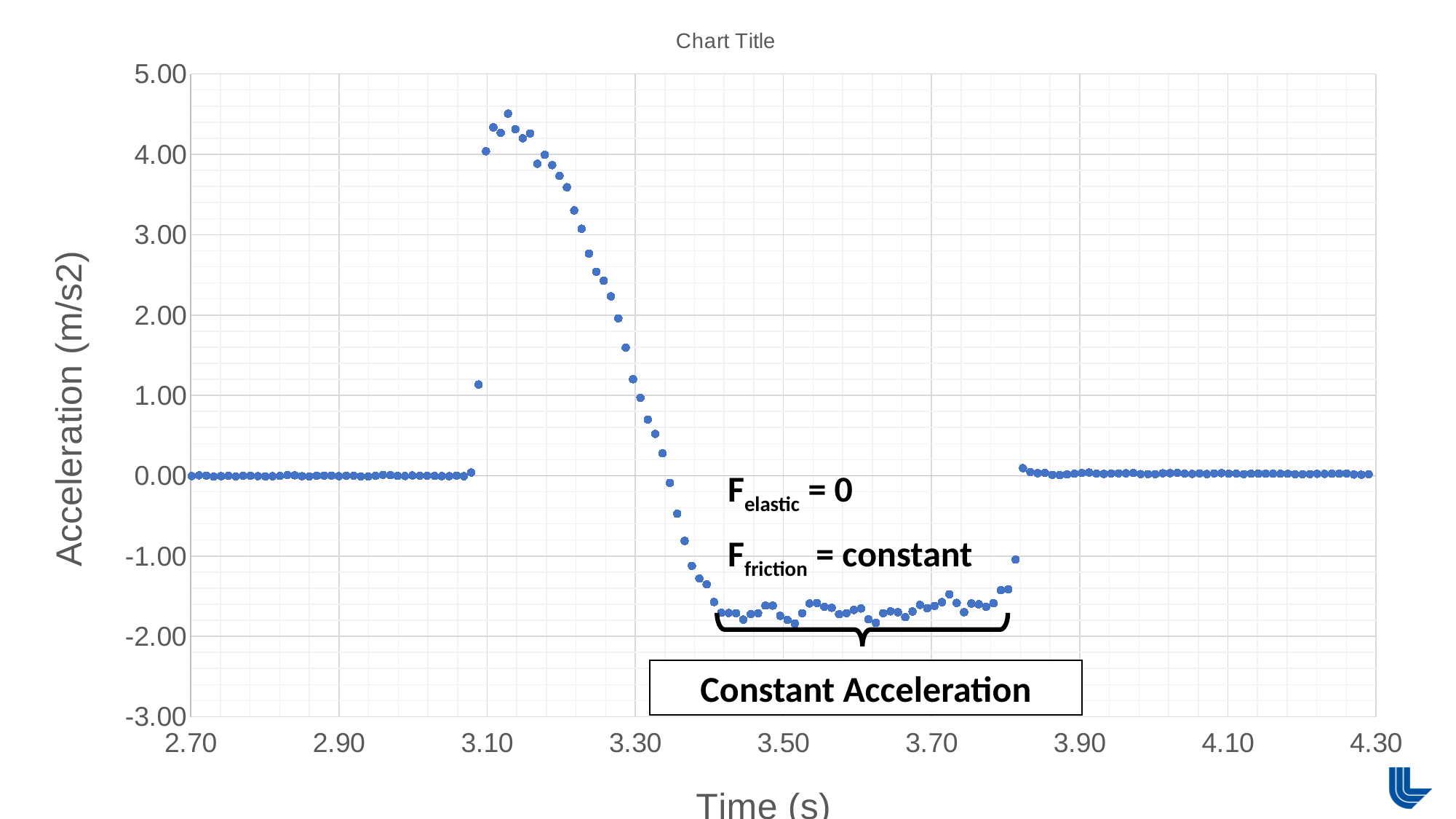
Which is larger, the acceleration value at time 3.10 or at time 3.50? 3.10 What is the title of the chart? Chart Title Is the acceleration value at time 2.90 greater or less than 1.00? less Between time 3.15 and 3.40, do the plotted acceleration values rise or fall? fall Is the highest plotted acceleration value greater or less than 4.00? greater Is the acceleration value at time 3.20 greater or less than 3.00? greater Which is larger, the acceleration value at time 3.90 or at time 3.60? 3.90 What is the label of the vertical axis? Acceleration (m/s2) What kind of chart is shown on the slide? scatter chart